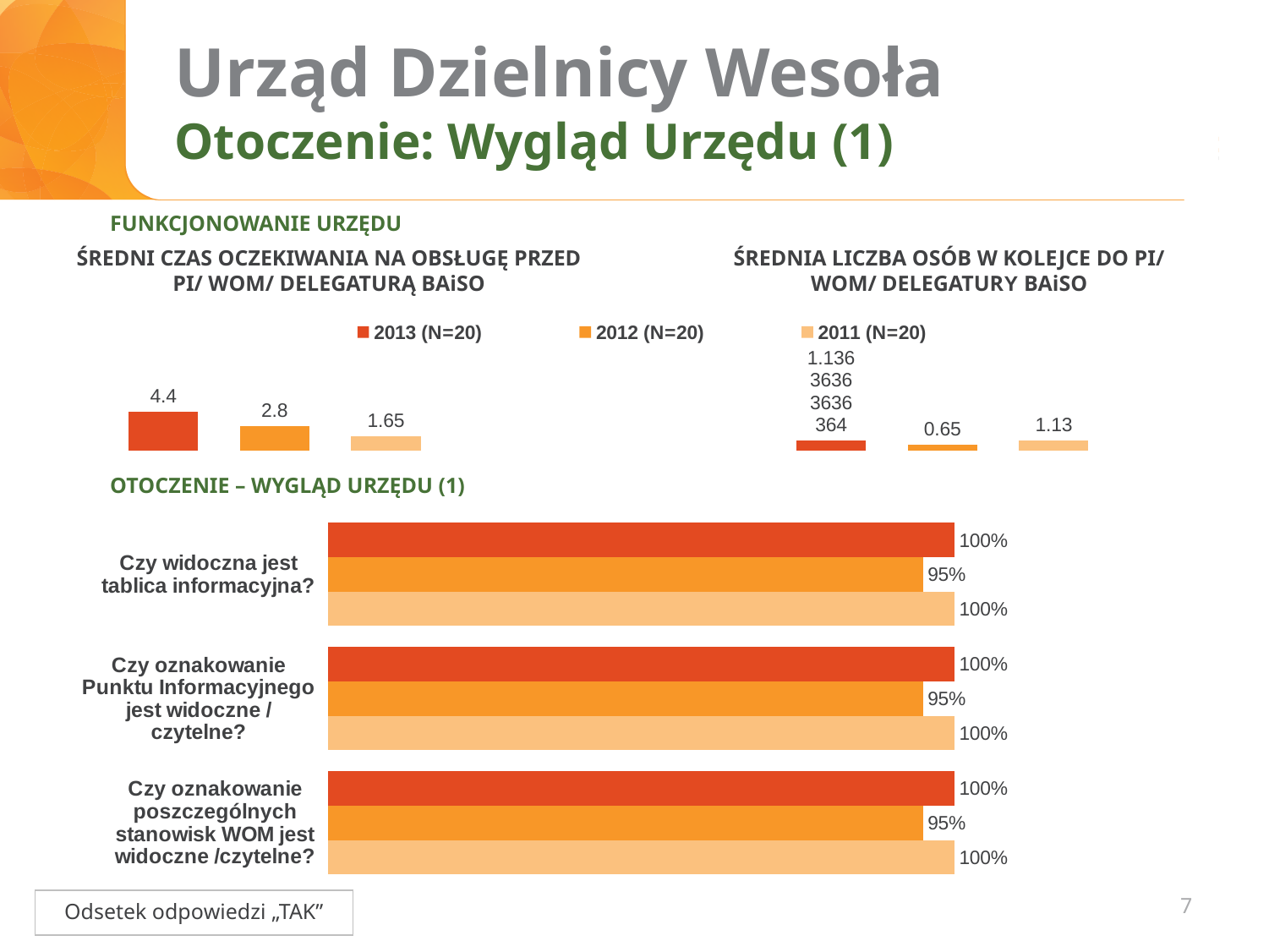
What kind of chart is the bottom chart 'OTOCZENIE – WYGLĄD URZĘDU (1)'? bar chart In the chart 'ŚREDNIA LICZBA OSÓB W KOLEJCE DO PI/ WOM/ DELEGATURY BAiSO', what is the value for 2012 (N=20)? 0.65 In the chart 'ŚREDNIA LICZBA OSÓB W KOLEJCE DO PI/ WOM/ DELEGATURY BAiSO', which year has the lowest value? 2012 (N=20) How many series does the legend list for the top charts? 3 In the chart 'ŚREDNIA LICZBA OSÓB W KOLEJCE DO PI/ WOM/ DELEGATURY BAiSO', what is the value for 2011 (N=20)? 1.13 In the bottom chart 'OTOCZENIE – WYGLĄD URZĘDU (1)', what is the 2013 value for 'Czy oznakowanie poszczególnych stanowisk WOM jest widoczne /czytelne?'? 100% In the chart 'ŚREDNI CZAS OCZEKIWANIA NA OBSŁUGĘ PRZED PI/ WOM/ DELEGATURĄ BAiSO', what is the value for 2013 (N=20)? 4.4 In the chart 'ŚREDNI CZAS OCZEKIWANIA NA OBSŁUGĘ PRZED PI/ WOM/ DELEGATURĄ BAiSO', do the values rise or fall from 2013 to 2011? fall In the chart 'ŚREDNI CZAS OCZEKIWANIA NA OBSŁUGĘ PRZED PI/ WOM/ DELEGATURĄ BAiSO', which year has the highest value? 2013 (N=20) In the bottom chart 'OTOCZENIE – WYGLĄD URZĘDU (1)', what is the 2012 value for 'Czy widoczna jest tablica informacyjna?'? 95% In the chart 'ŚREDNI CZAS OCZEKIWANIA NA OBSŁUGĘ PRZED PI/ WOM/ DELEGATURĄ BAiSO', what is the difference between the 2013 and 2012 values? 1.6 In the chart 'ŚREDNI CZAS OCZEKIWANIA NA OBSŁUGĘ PRZED PI/ WOM/ DELEGATURĄ BAiSO', what is the value for 2011 (N=20)? 1.65